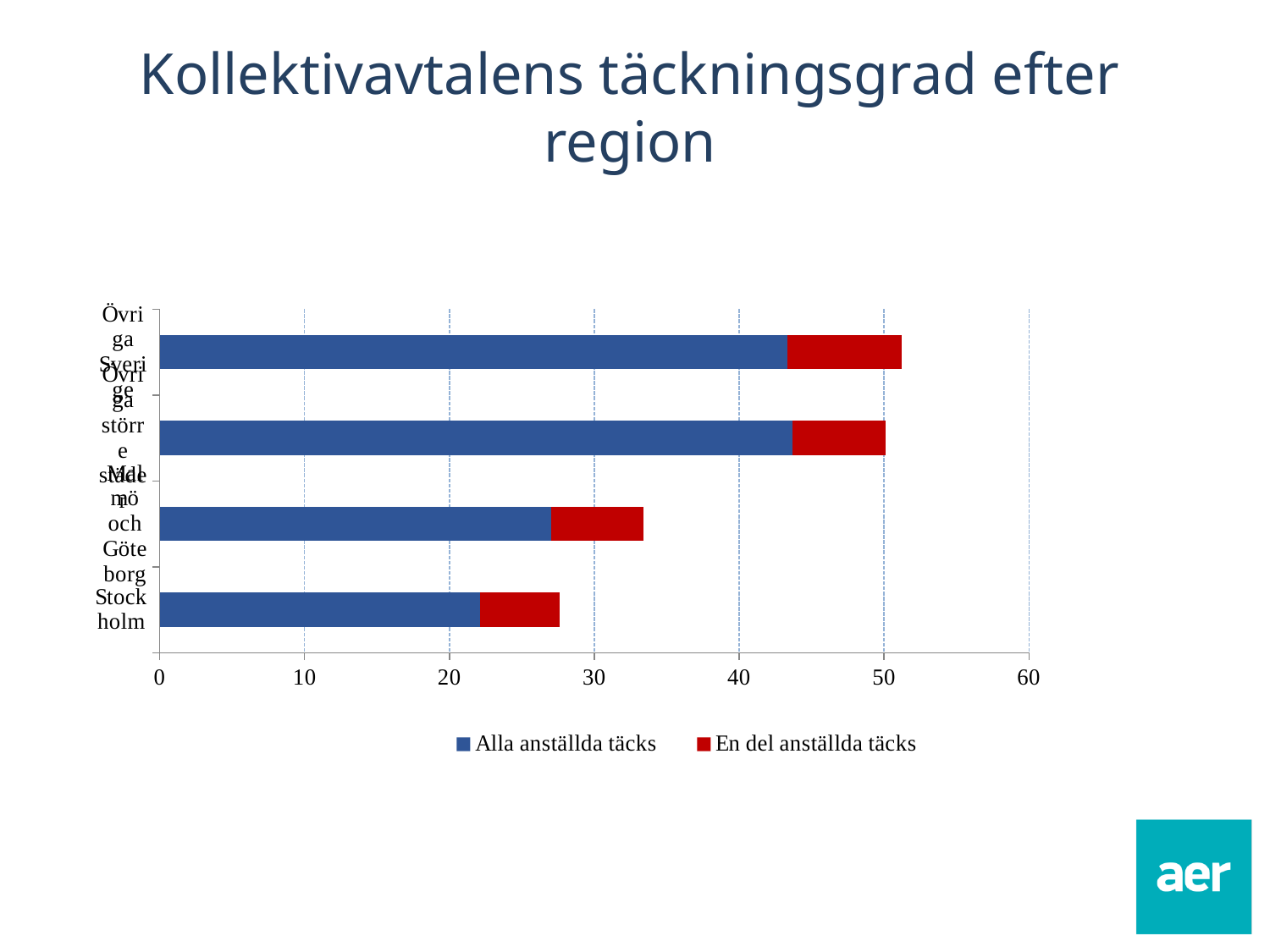
Is the total bar for the topmost region (Övriga Sverige) greater or less than 40? greater Is the total bar for Malmö och Göteborg greater or less than 30? greater Which region has the shortest total bar? Stockholm Which is larger, the total bar for Stockholm or the total bar for Malmö och Göteborg? Malmö och Göteborg Is the 'Alla anställda täcks' value for Stockholm greater or less than 20? greater What is the title of the slide? Kollektivavtalens täckningsgrad efter region Which series is shown in red in the legend? En del anställda täcks How many bars (regions) are plotted in the chart? 4 What kind of chart is shown on the slide? Stacked bar chart How many series does the legend list? 2